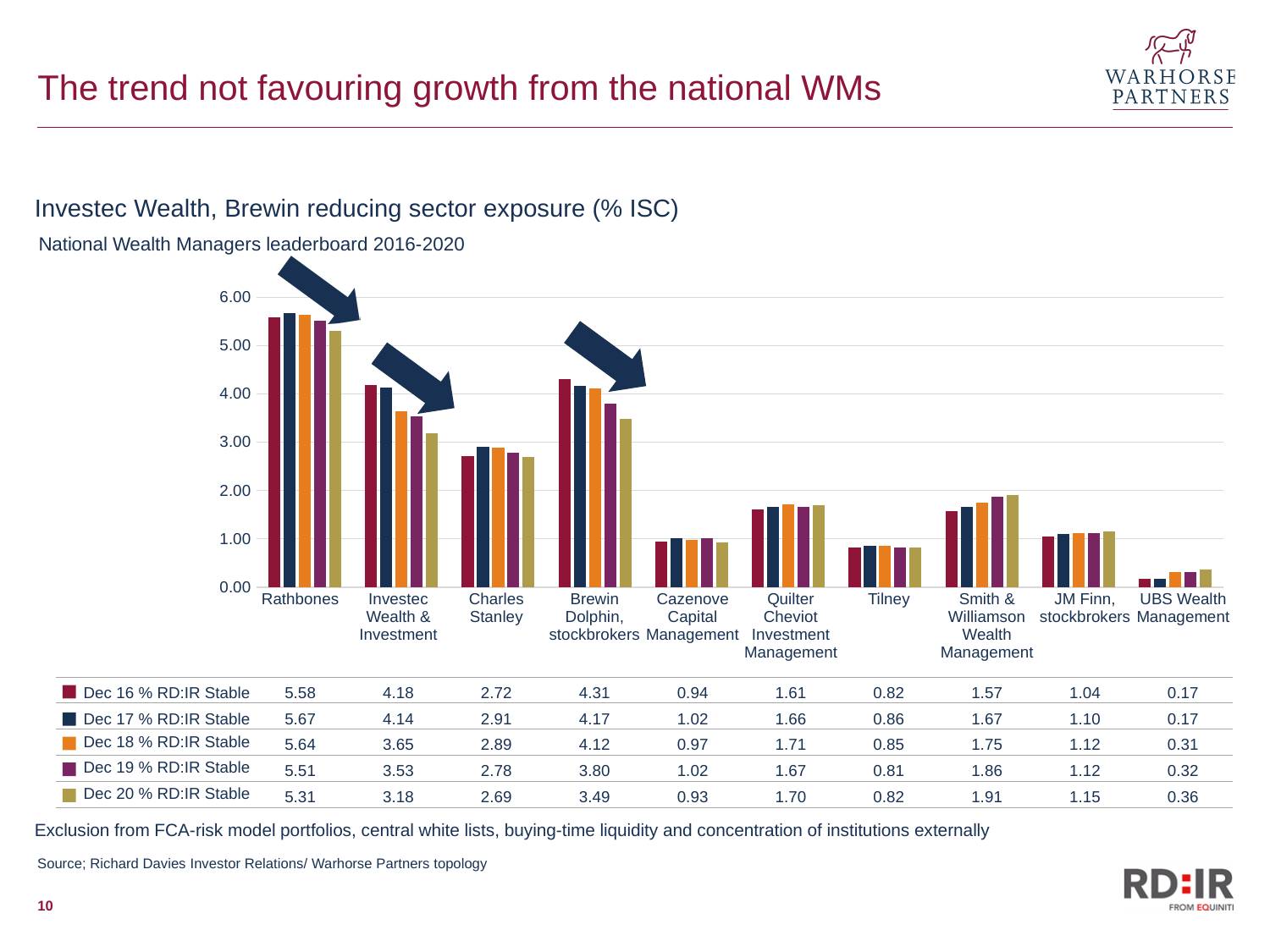
Do the values for Smith & Williamson Wealth Management rise or fall from Dec 16 to Dec 20? Rise Which wealth manager has the highest Dec 20 % RD:IR Stable value? Rathbones What is the difference between the Dec 16 and Dec 20 values for Brewin Dolphin, stockbrokers? 0.82 What kind of chart is shown on the slide? Bar chart How many wealth managers are shown on the x axis of the chart? 10 Which has the larger Dec 16 value, Brewin Dolphin, stockbrokers or Charles Stanley? Brewin Dolphin, stockbrokers By how much did the % RD:IR Stable value for Investec Wealth & Investment fall from Dec 16 to Dec 20? 1.00 Which wealth manager has the lowest Dec 16 % RD:IR Stable value? UBS Wealth Management What is the Dec 16 % RD:IR Stable value for Rathbones? 5.58 How many series does the legend list? 5 What is the Dec 19 % RD:IR Stable value for Smith & Williamson Wealth Management? 1.86 What is the Dec 20 % RD:IR Stable value for UBS Wealth Management? 0.36